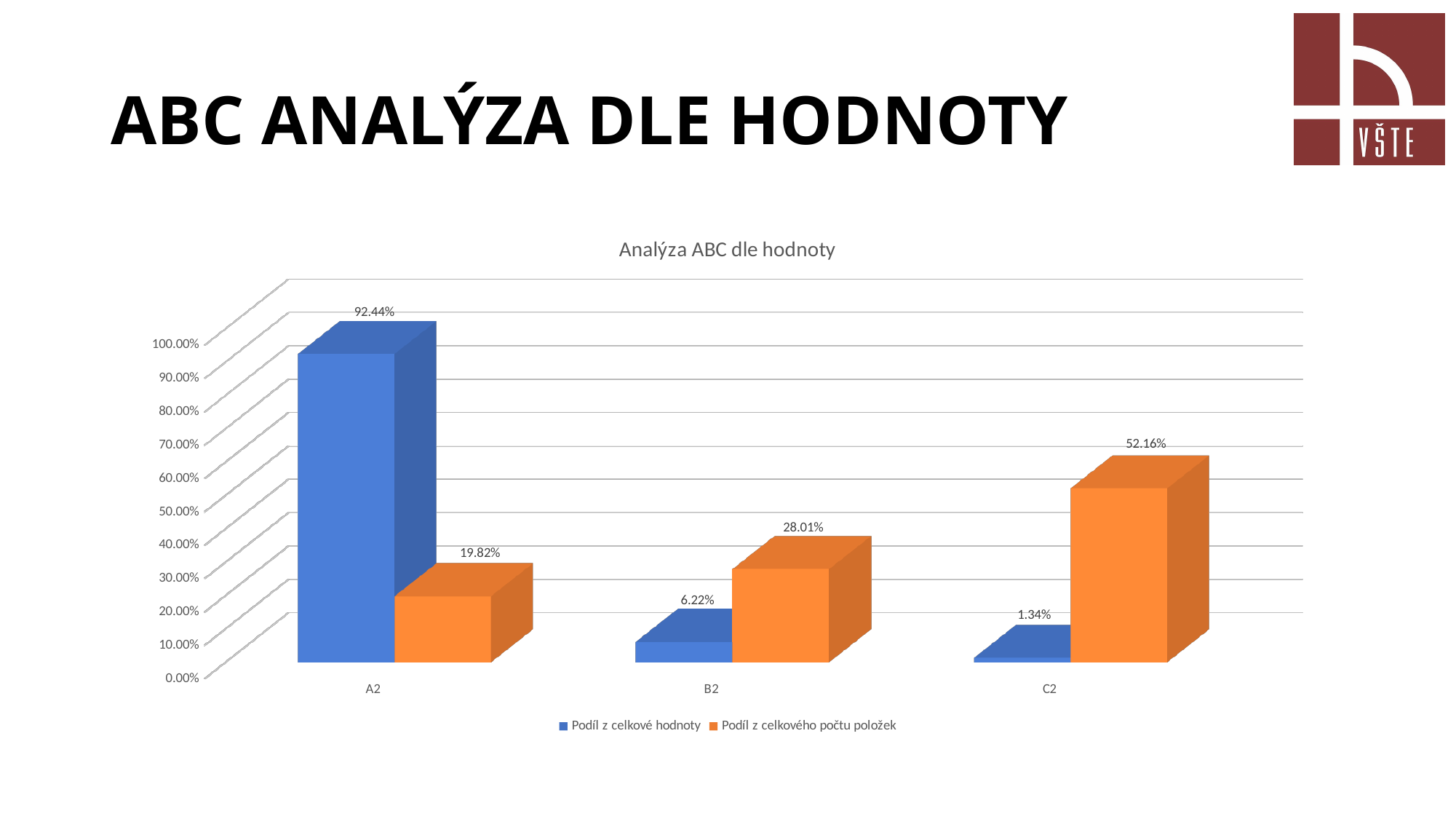
What is the difference between the "Podíl z celkového počtu položek" values for C2 and B2? 24.15% Which category has the lowest value for "Podíl z celkového počtu položek"? A2 What is the value of "Podíl z celkového počtu položek" for A2? 19.82% What is the value of "Podíl z celkového počtu položek" for C2? 52.16% What is the value of "Podíl z celkové hodnoty" for B2? 6.22% How many series does the legend list? 2 How many categories are shown on the x axis? 3 What is the value of "Podíl z celkové hodnoty" for A2? 92.44% Which is larger for B2: "Podíl z celkové hodnoty" or "Podíl z celkového počtu položek"? Podíl z celkového počtu položek What kind of chart is shown on the slide? Bar chart What is the title of the chart? Analýza ABC dle hodnoty Which category has the highest value for "Podíl z celkové hodnoty"? A2